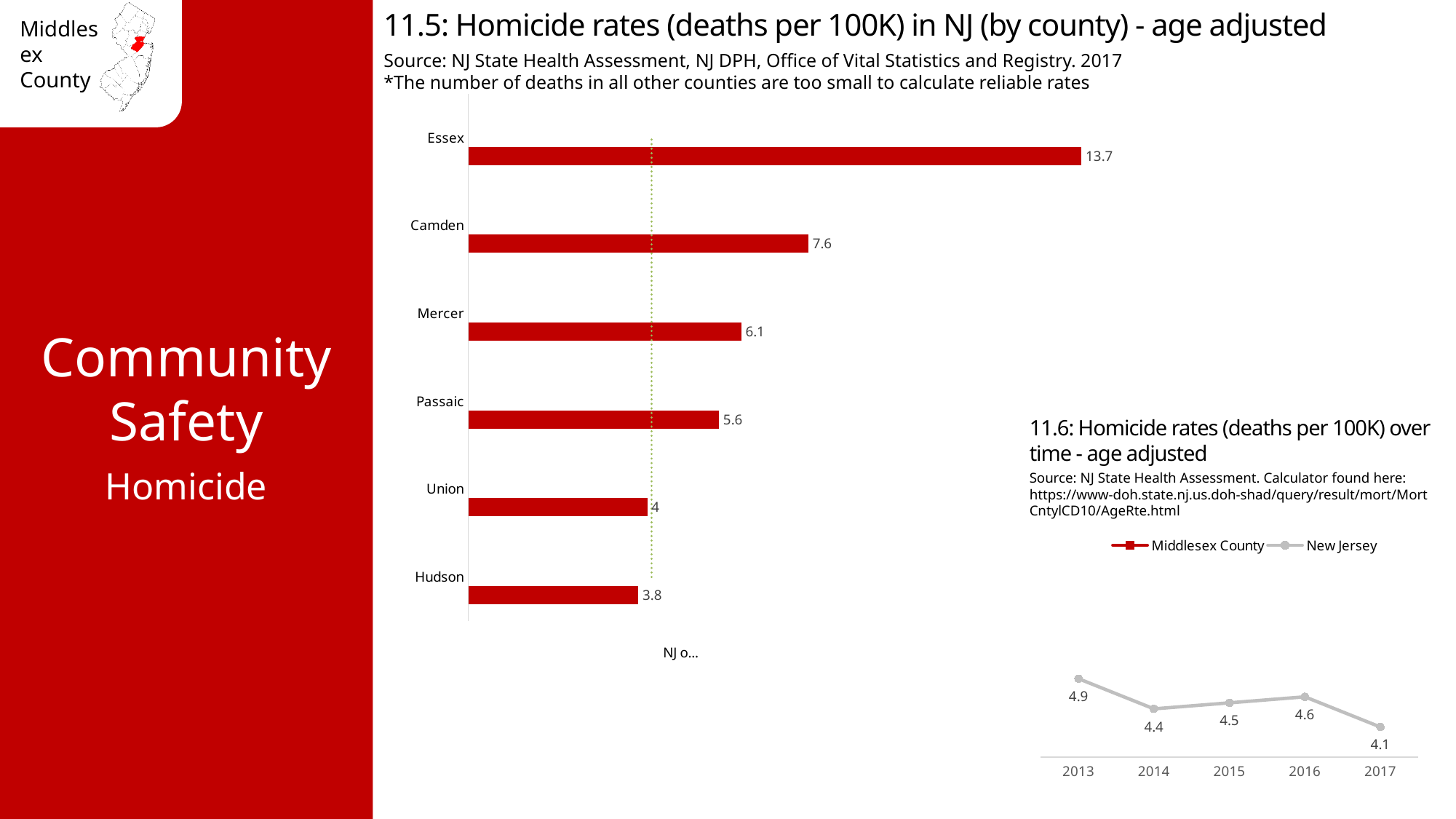
In chart 11.6, what is the value shown for 2013? 4.9 What kind of chart is chart 11.5? Bar chart In chart 11.6, what is the difference between the values for 2016 and 2017? 0.5 In chart 11.6, what is the value shown for 2017? 4.1 In chart 11.5, which county has the highest homicide rate? Essex In chart 11.5, what is the homicide rate for Passaic? 5.6 In chart 11.5, how many counties are shown? 6 In chart 11.5, which county has a higher homicide rate, Union or Hudson? Union In chart 11.5, what is the homicide rate for Essex? 13.7 In chart 11.6, how many series does the legend list? 2 In chart 11.5, which county has the lowest homicide rate? Hudson In chart 11.5, what is the difference between the homicide rates of Camden and Mercer? 1.5